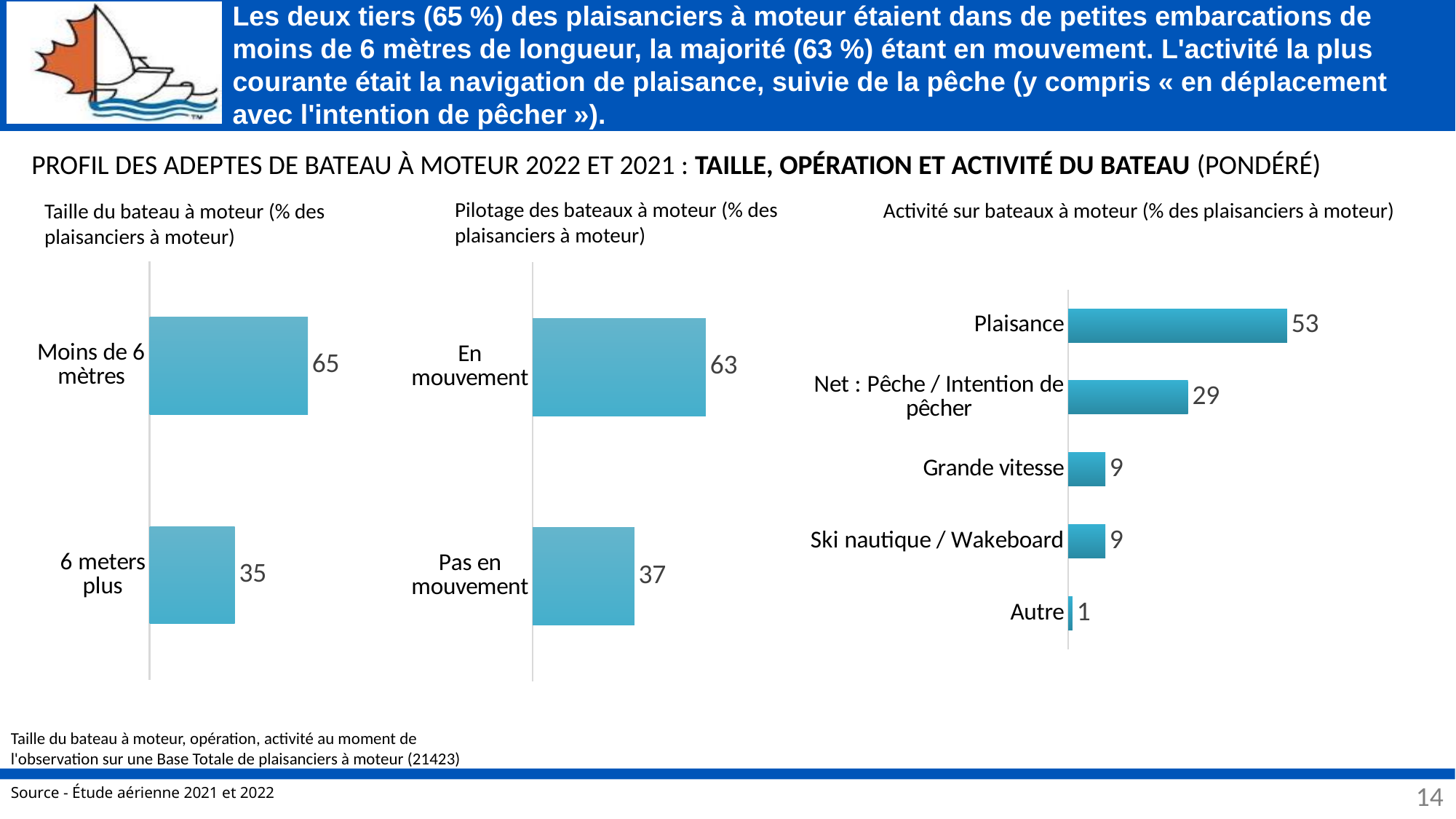
In the chart 'Activité sur bateaux à moteur', which category has the lowest value? Autre In the chart 'Taille du bateau à moteur', what is the difference between 'Moins de 6 mètres' and '6 meters plus'? 30 In the chart 'Pilotage des bateaux à moteur', what is the value for 'En mouvement'? 63 In the chart 'Activité sur bateaux à moteur', which category has the highest value? Plaisance What type of chart is the 'Activité sur bateaux à moteur' chart? Bar chart In the chart 'Pilotage des bateaux à moteur', which category is larger, 'En mouvement' or 'Pas en mouvement'? En mouvement In the chart 'Taille du bateau à moteur', what is the value for 'Moins de 6 mètres'? 65 In the chart 'Activité sur bateaux à moteur', what is the value for 'Net : Pêche / Intention de pêcher'? 29 In the chart 'Activité sur bateaux à moteur', how many categories are shown? 5 In the chart 'Activité sur bateaux à moteur', what is the difference between 'Plaisance' and 'Net : Pêche / Intention de pêcher'? 24 In the chart 'Taille du bateau à moteur', what is the value for '6 meters plus'? 35 In the chart 'Pilotage des bateaux à moteur', what is the difference between 'En mouvement' and 'Pas en mouvement'? 26